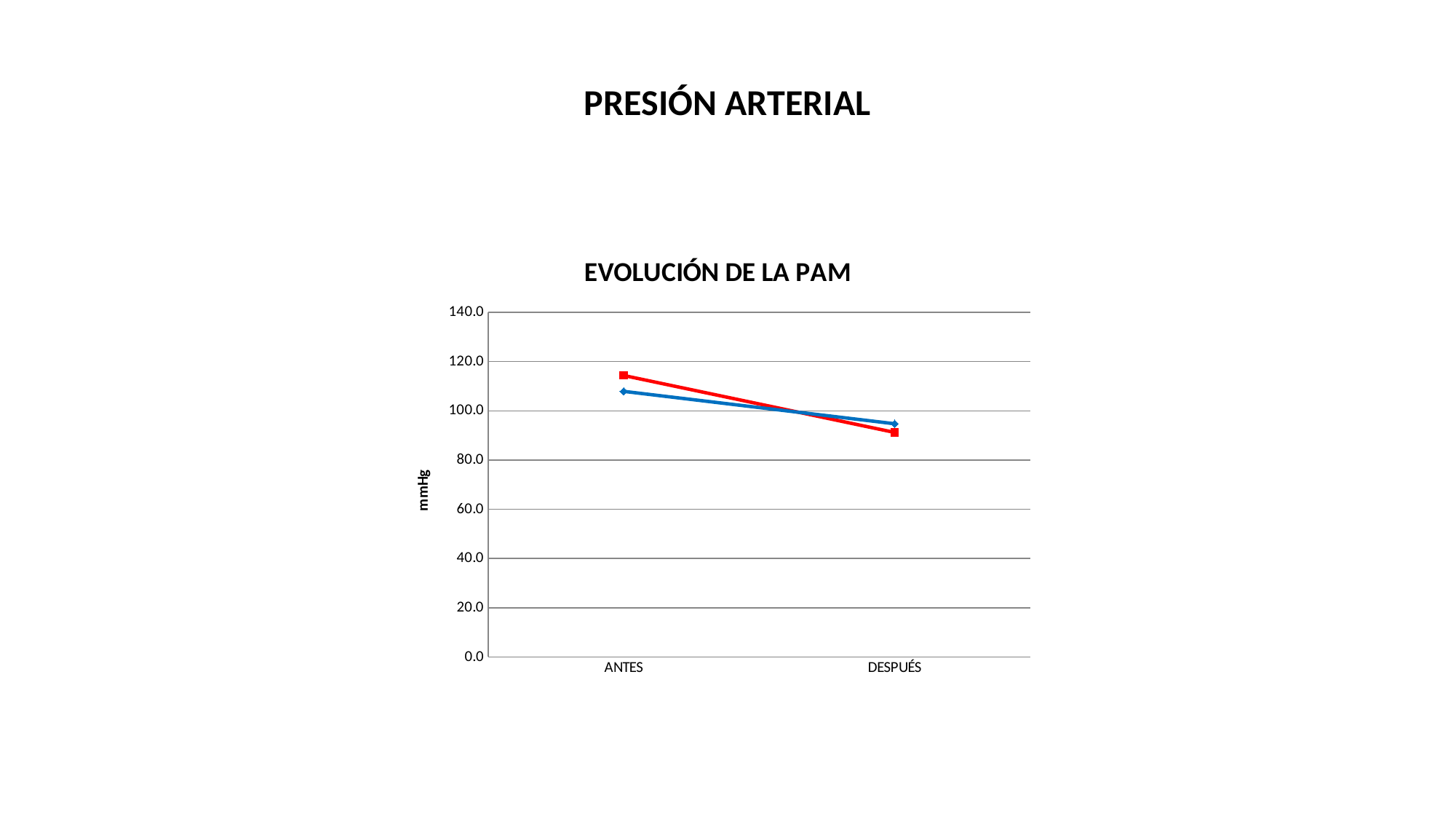
Is the value of the red line at DESPUÉS greater or less than 100? less What is the label on the vertical axis of the chart? mmHg Do the values of the red line rise or fall from ANTES to DESPUÉS? fall Is the value of the red line at ANTES greater or less than 100? greater What are the two categories on the x axis of the chart? ANTES and DESPUÉS Is the value of the blue line at DESPUÉS greater or less than 80? greater Do the values of the blue line rise or fall from ANTES to DESPUÉS? fall How many lines are plotted on the chart? 2 What kind of chart is shown under the title EVOLUCIÓN DE LA PAM? line chart How many categories are shown on the x axis of the chart? 2 At ANTES, which line has the higher value, the red line or the blue line? the red line